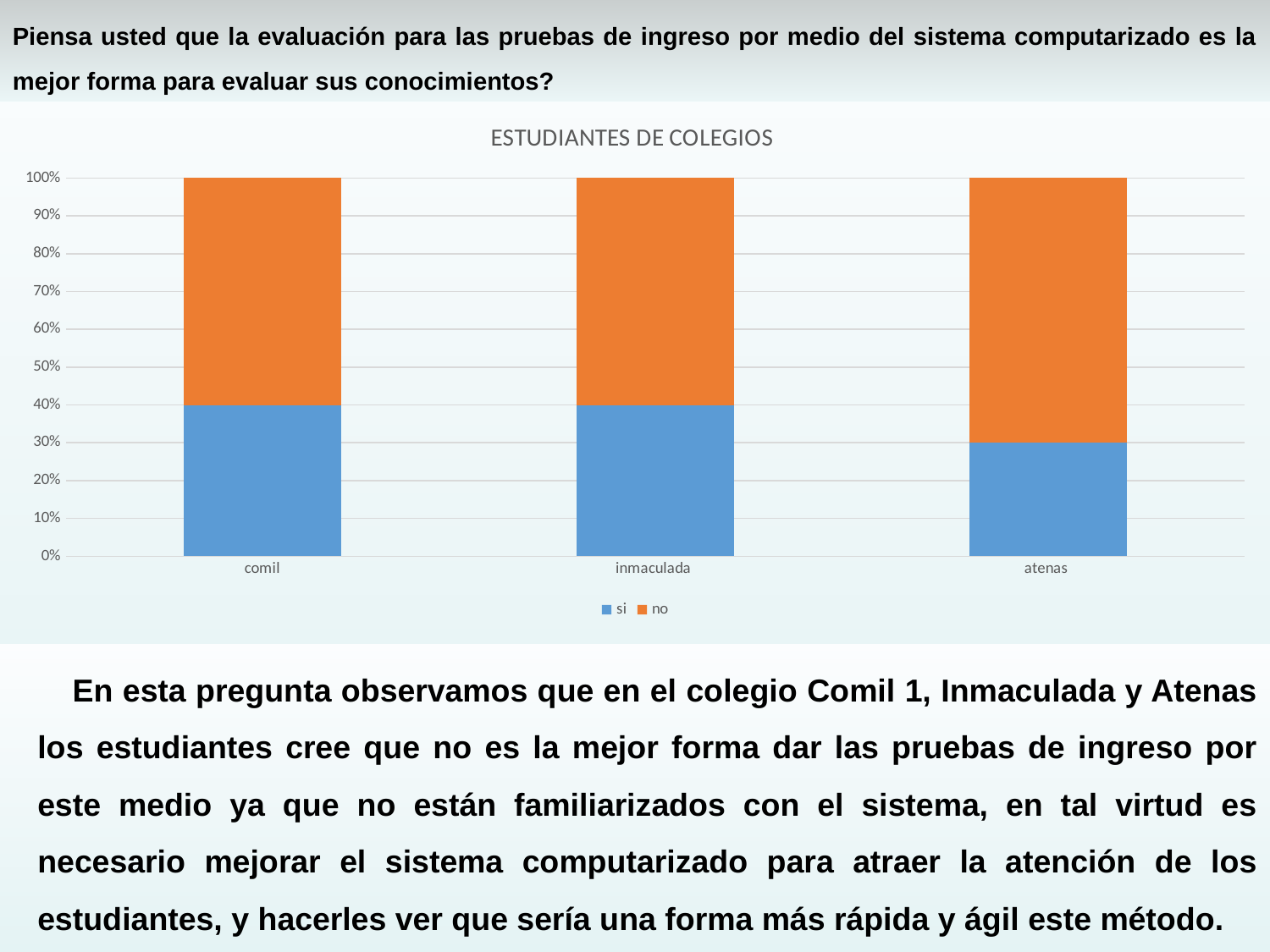
Which college has the lowest 'si' value? atenas For atenas, which series is larger, 'si' or 'no'? no What is the value of the 'si' series for atenas? 30% How many colleges (categories) are shown on the x axis of the chart? 3 What kind of chart is shown on the slide? Stacked bar chart What is the title of the chart? ESTUDIANTES DE COLEGIOS What is the value of the 'si' series for comil? 40% Is the 'no' value for atenas greater or less than 60%? greater How many series does the chart legend list? 2 Which has a larger 'si' value, comil or atenas? comil Is the 'si' value for inmaculada greater or less than 50%? less What is the value of the 'si' series for inmaculada? 40%